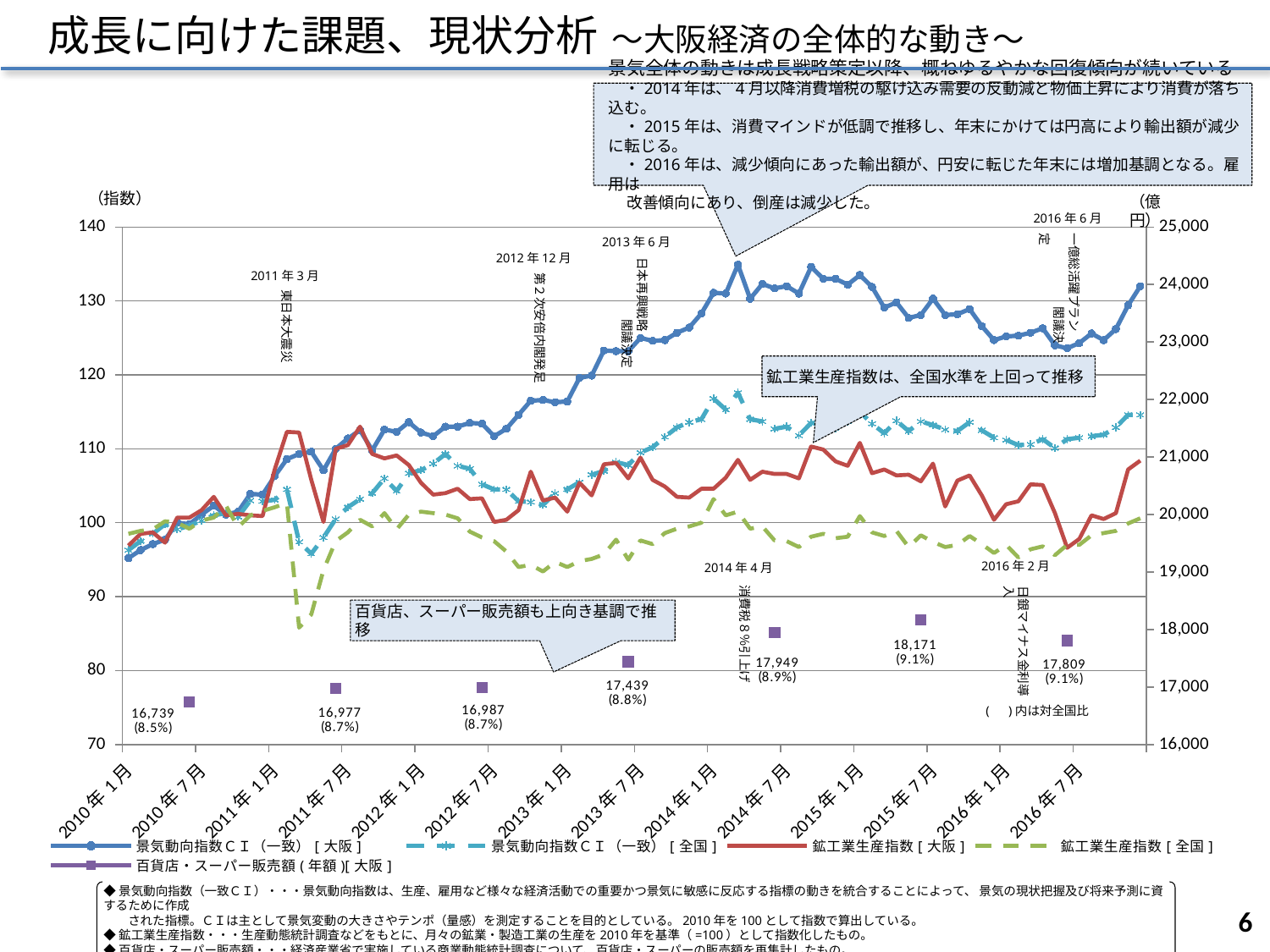
At 2014年7月, which is larger: 鉱工業生産指数[大阪] or 鉱工業生産指数[全国]? 鉱工業生産指数[大阪] What percentage (対全国比) is printed in parentheses under the value 17,949? 8.9% What is the difference between the printed values 18,171 and 17,809 for 百貨店・スーパー販売額(年額)[大阪]? 362 What percentage (対全国比) is printed in parentheses under the value 16,739? 8.5% Does 景気動向指数CI（一致）[大阪] rise or fall from 2010年1月 to 2014年1月? rise Is the value of 景気動向指数CI（一致）[大阪] at 2016年1月 greater or less than 130? less What kind of chart is shown on the slide? line chart How many series does the legend list? 5 What is the highest printed value for 百貨店・スーパー販売額(年額)[大阪]? 18,171 How many data points are printed with values for 百貨店・スーパー販売額(年額)[大阪]? 7 Is the value of 景気動向指数CI（一致）[大阪] at 2010年1月 greater or less than 100? less What is the lowest printed value for 百貨店・スーパー販売額(年額)[大阪]? 16,739